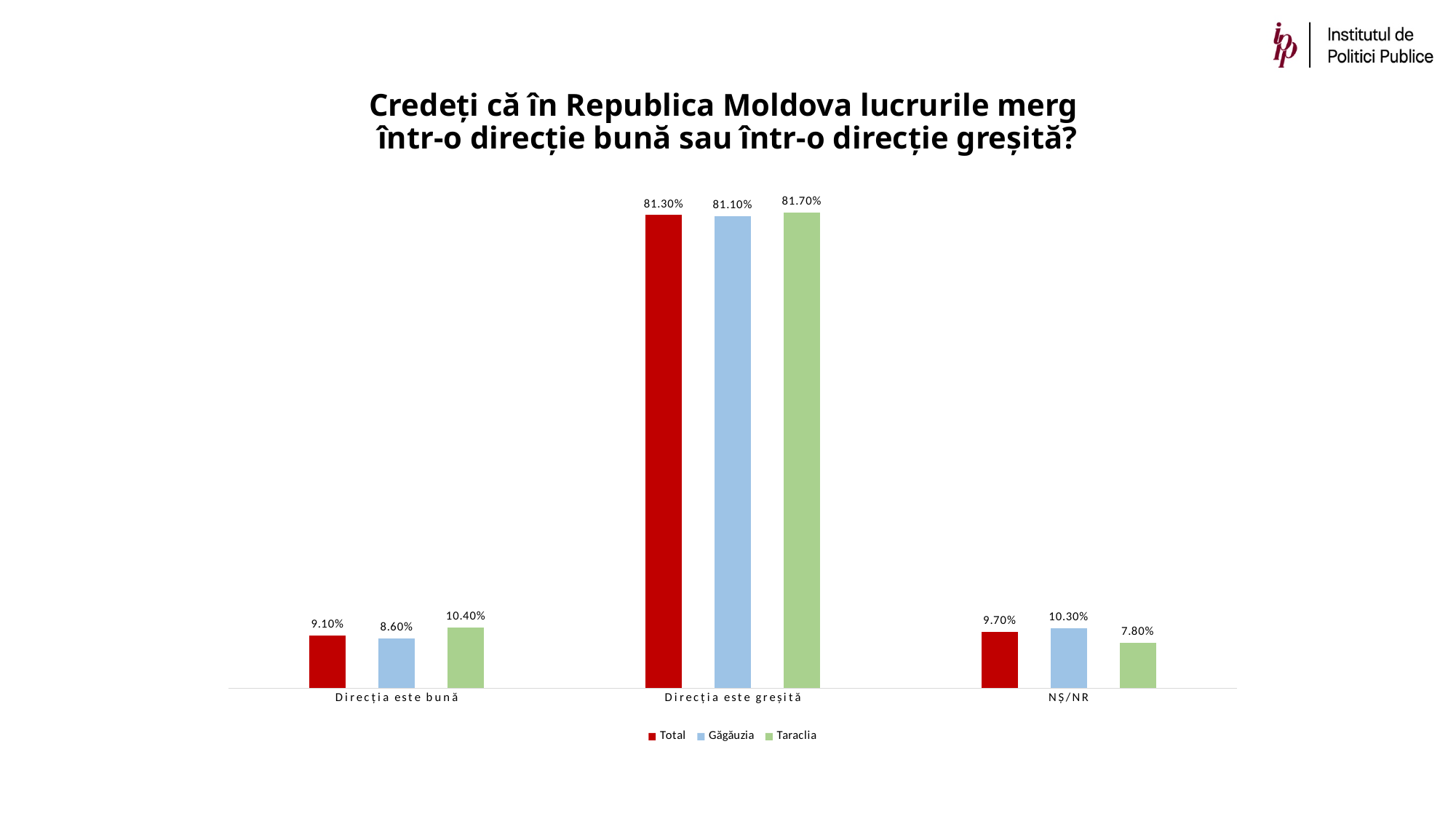
Which colour represents the Total series in the legend? Red How many categories are shown on the x axis? 3 What is the Găgăuzia value for "Direcția este bună"? 8.60% What is the Găgăuzia value for "NȘ/NR"? 10.30% What is the Total value for "Direcția este greșită"? 81.30% What is the difference between the Taraclia and Găgăuzia values for "Direcția este bună"? 1.80% What kind of chart is shown on the slide? Bar chart Which is larger for "NȘ/NR": the Găgăuzia value or the Taraclia value? Găgăuzia How many series does the legend list? 3 What is the Taraclia value for "NȘ/NR"? 7.80% Which category has the lowest Taraclia value? NȘ/NR Which category has the highest Total value? Direcția este greșită